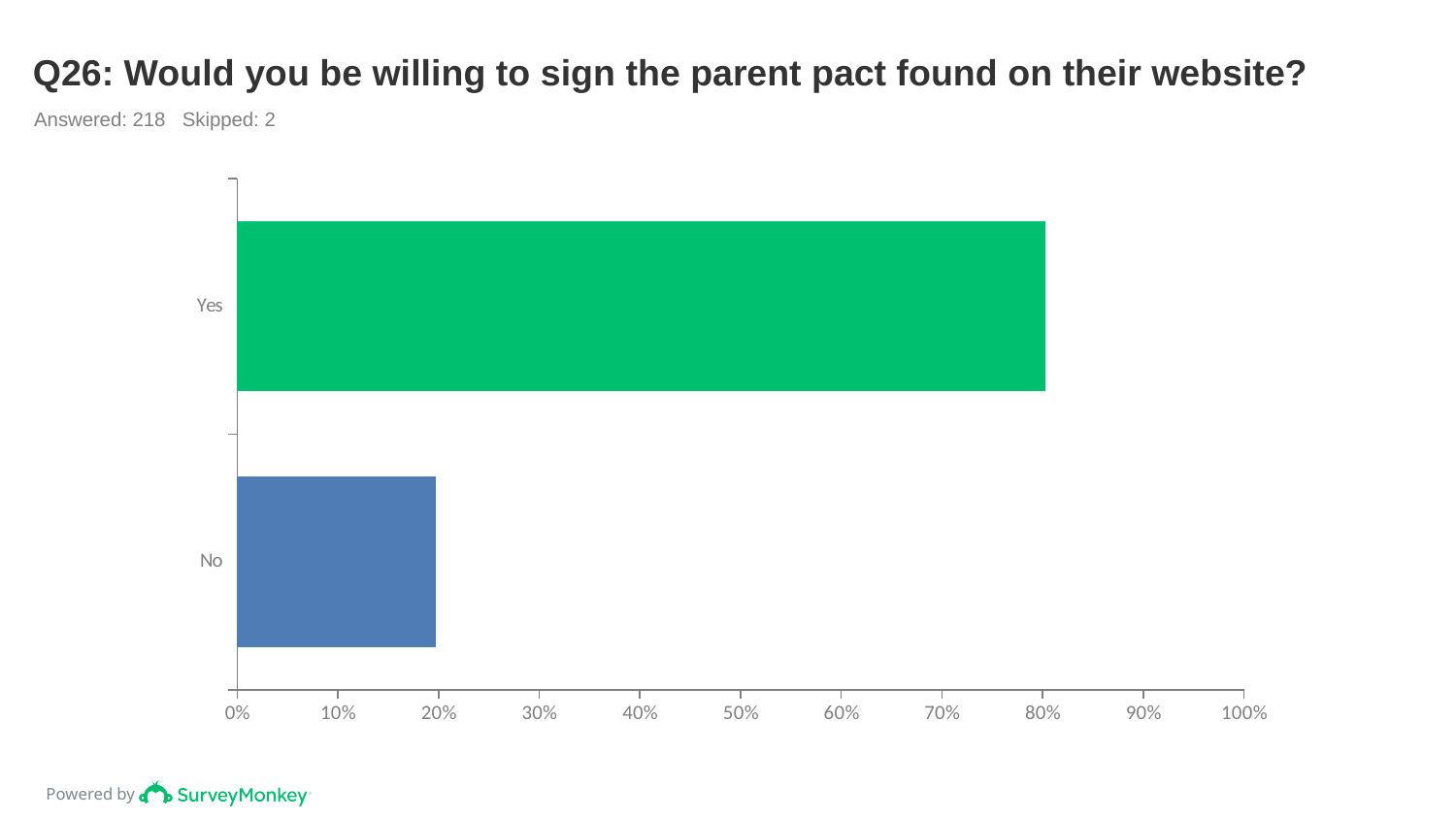
How many respondents answered this question according to the slide? 218 Which response category has the highest value? Yes How many response categories are shown in the chart? 2 Is the value for Yes greater or less than 70%? greater Is the value for No greater or less than 30%? less Is the value for Yes greater or less than 90%? less What is the title of the chart? Q26: Would you be willing to sign the parent pact found on their website? Which response category has the lowest value? No Which is larger, the value for Yes or the value for No? Yes What kind of chart is shown on the slide? Bar chart